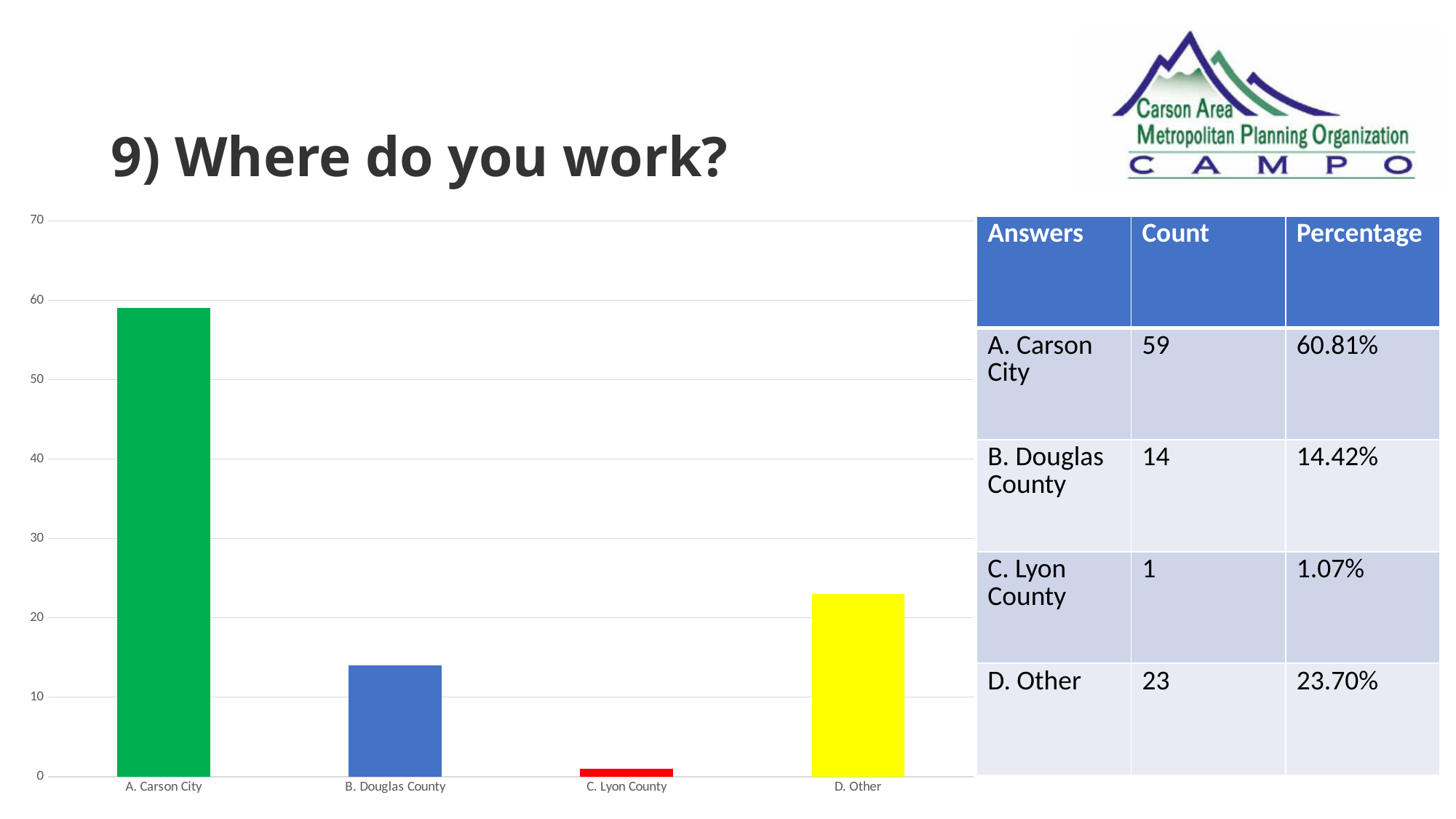
Which has a larger count, B. Douglas County or D. Other? D. Other What is the difference in count between A. Carson City and D. Other? 36 What is the count for A. Carson City? 59 Is the value for A. Carson City greater or less than 50? greater What is the count for D. Other? 23 Which category has the highest bar in the chart? A. Carson City What percentage is shown for C. Lyon County? 1.07% How many categories does the bar chart show? 4 What kind of chart is shown on the slide? bar chart What colour is the bar for D. Other? yellow Which category has the lowest bar in the chart? C. Lyon County What is the count for B. Douglas County? 14